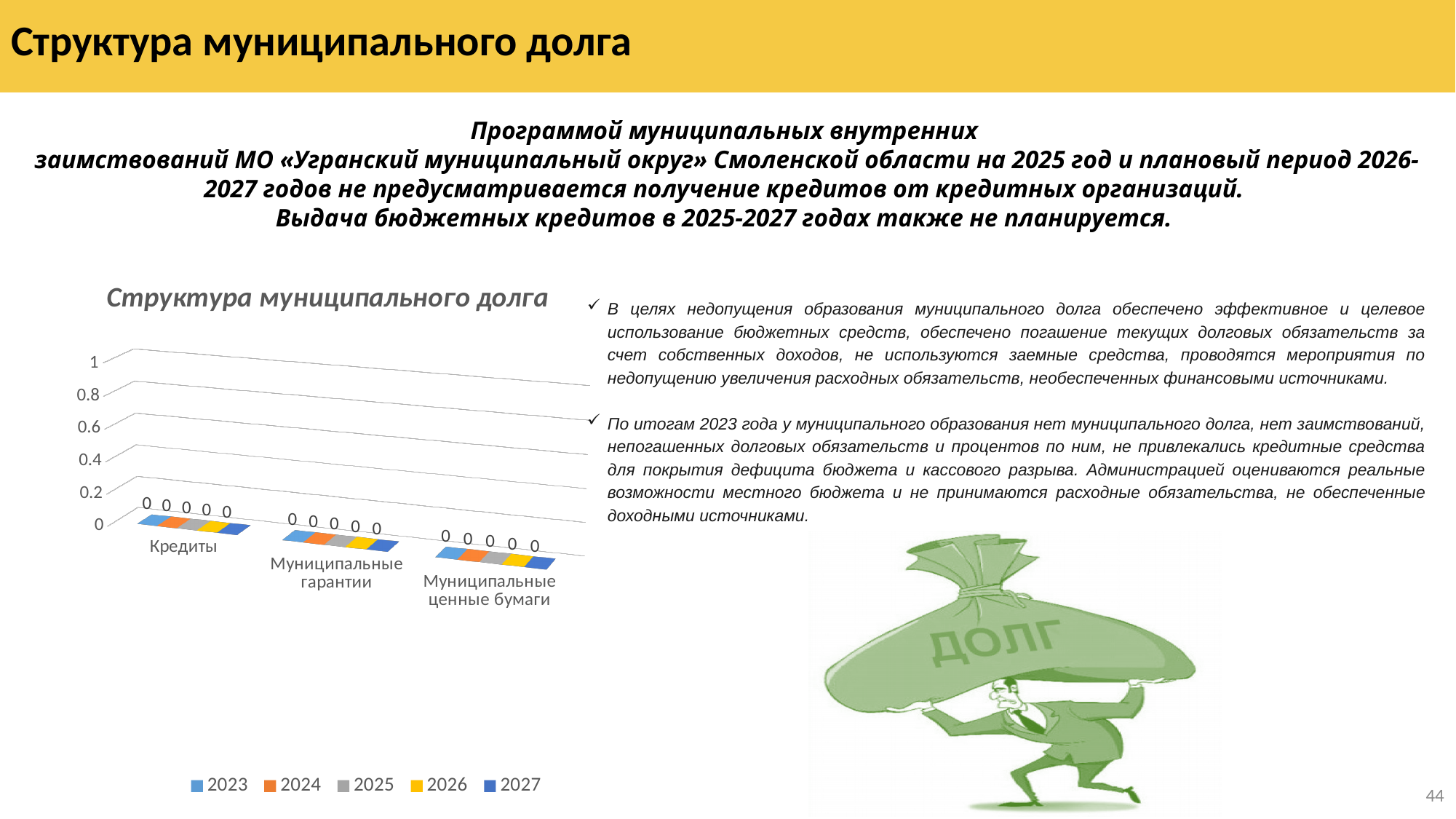
What is the difference between the 2024 value for Кредиты and the 2024 value for Муниципальные ценные бумаги? 0 What kind of chart is shown on the slide? bar chart What is the title of the chart? Структура муниципального долга Is the value for Муниципальные гарантии in 2027 greater or less than 0.2? less How many series does the chart legend list? 5 What is the value for Кредиты in 2026? 0 Which year does the orange series in the legend represent? 2024 How many categories are shown on the x axis of the chart? 3 What is the value for Муниципальные гарантии in 2025? 0 What is the value for Муниципальные ценные бумаги in 2027? 0 What is the total of the values for Муниципальные гарантии across all five years? 0 What is the value for Кредиты in 2023? 0